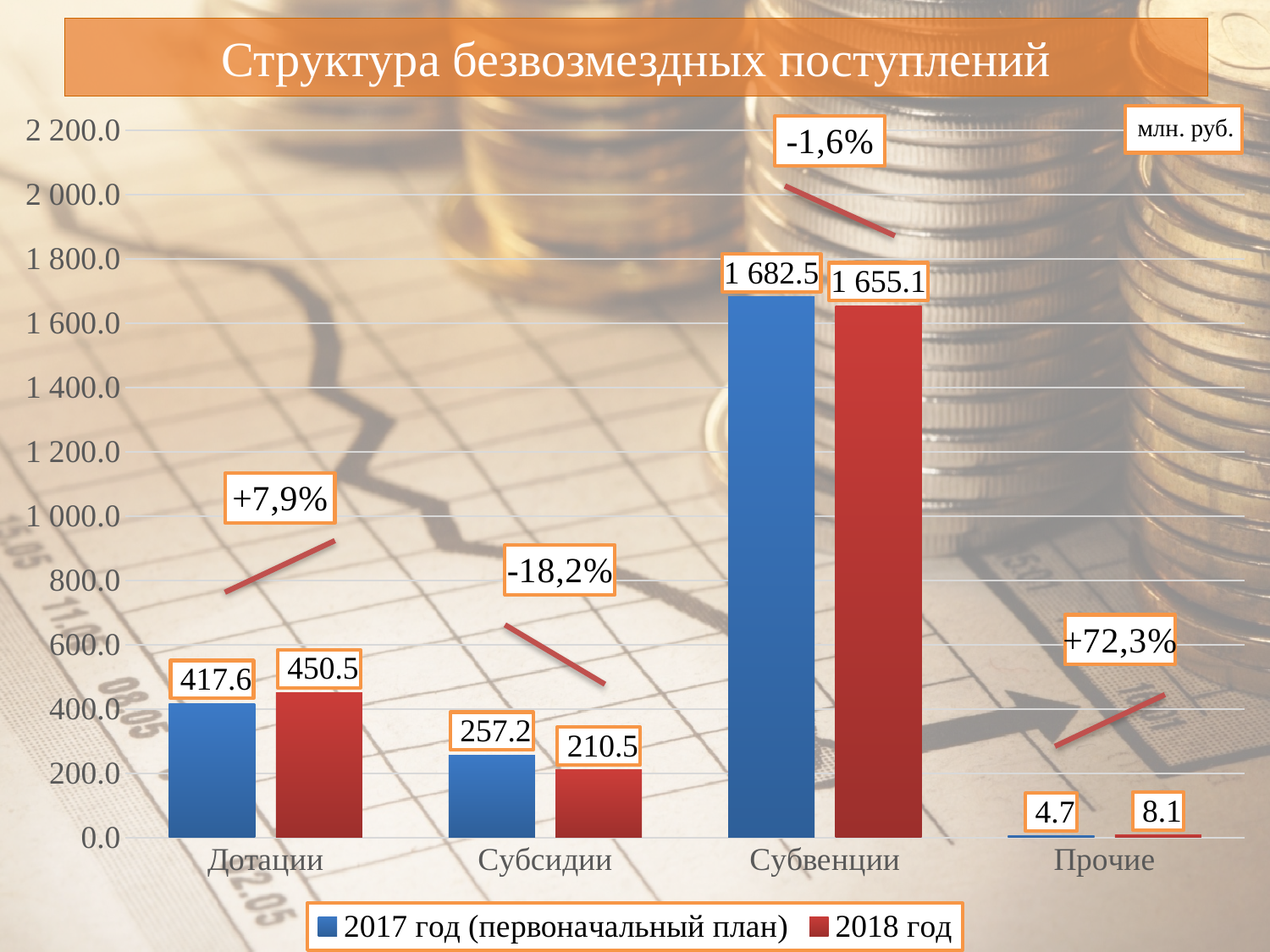
Which category has the highest value in the 2018 год series? Субвенции Which category has the lowest value in the 2017 год (первоначальный план) series? Прочие How many series does the legend list? 2 What is the value for Прочие in the 2018 год series? 8.1 Is the 2018 год value for Субвенции greater or less than 1 600.0? greater For Дотации, which is larger: the 2017 год (первоначальный план) value or the 2018 год value? 2018 год What is the value for Субвенции in the 2017 год (первоначальный план) series? 1 682.5 What is the difference between the 2017 год (первоначальный план) and 2018 год values for Субсидии? 46.7 How many categories are shown on the x axis? 4 What is the value for Дотации in the 2018 год series? 450.5 What kind of chart is shown on the slide? bar chart What percentage change is annotated above the Прочие bars? +72,3%